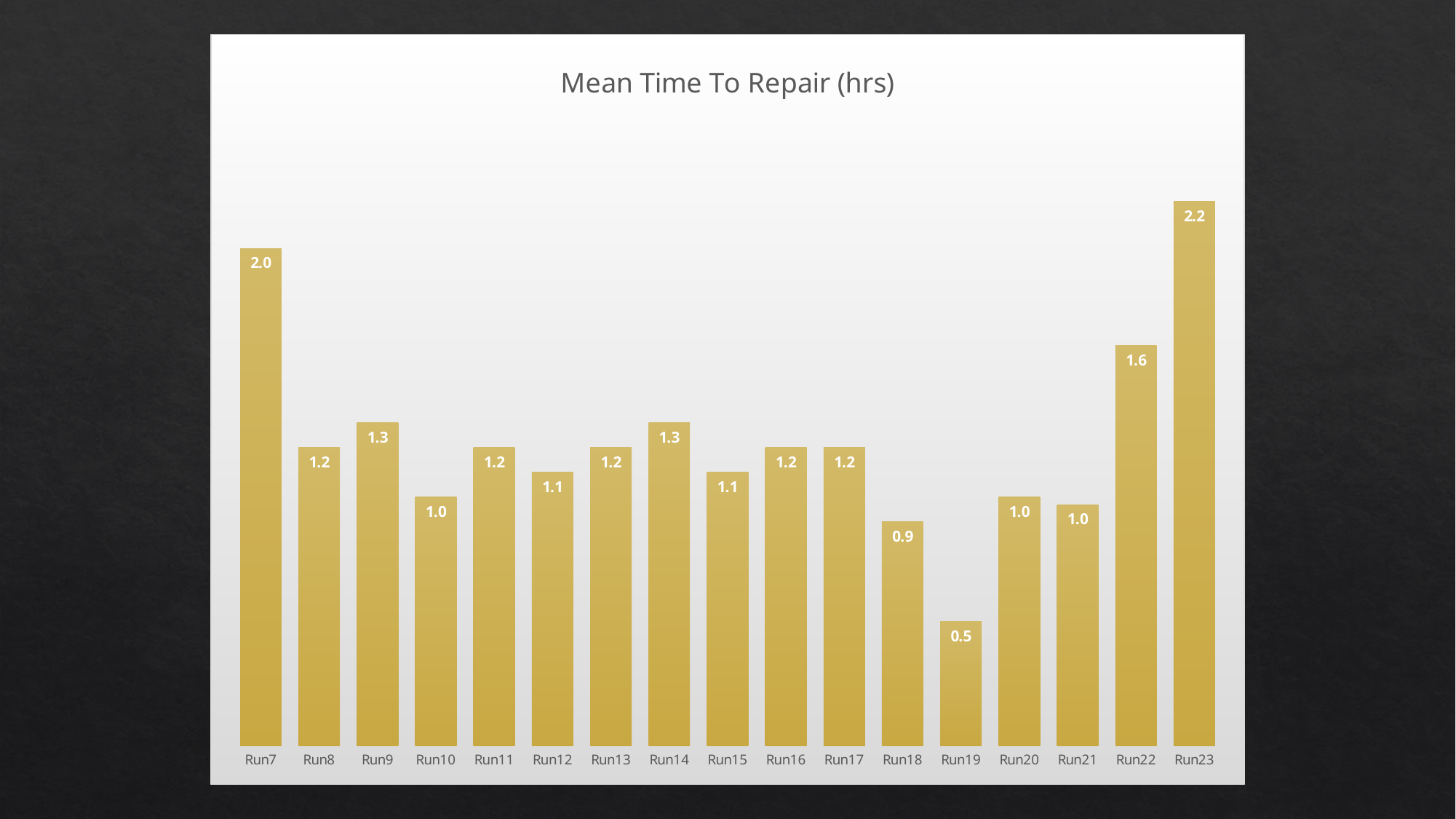
What is the value shown for Run19? 0.5 What is the title of the chart? Mean Time To Repair (hrs) What is the value shown for Run14? 1.3 What kind of chart is shown on the slide? Bar chart What is the difference between the values for Run22 and Run19? 1.1 What is the difference between the values for Run23 and Run7? 0.2 Which is larger, the value for Run9 or the value for Run18? Run9 What is the Mean Time To Repair value for Run7? 2.0 What is the value shown for Run22? 1.6 How many runs are shown on the x axis? 17 Which run has the highest Mean Time To Repair? Run23 Which run has the lowest Mean Time To Repair? Run19